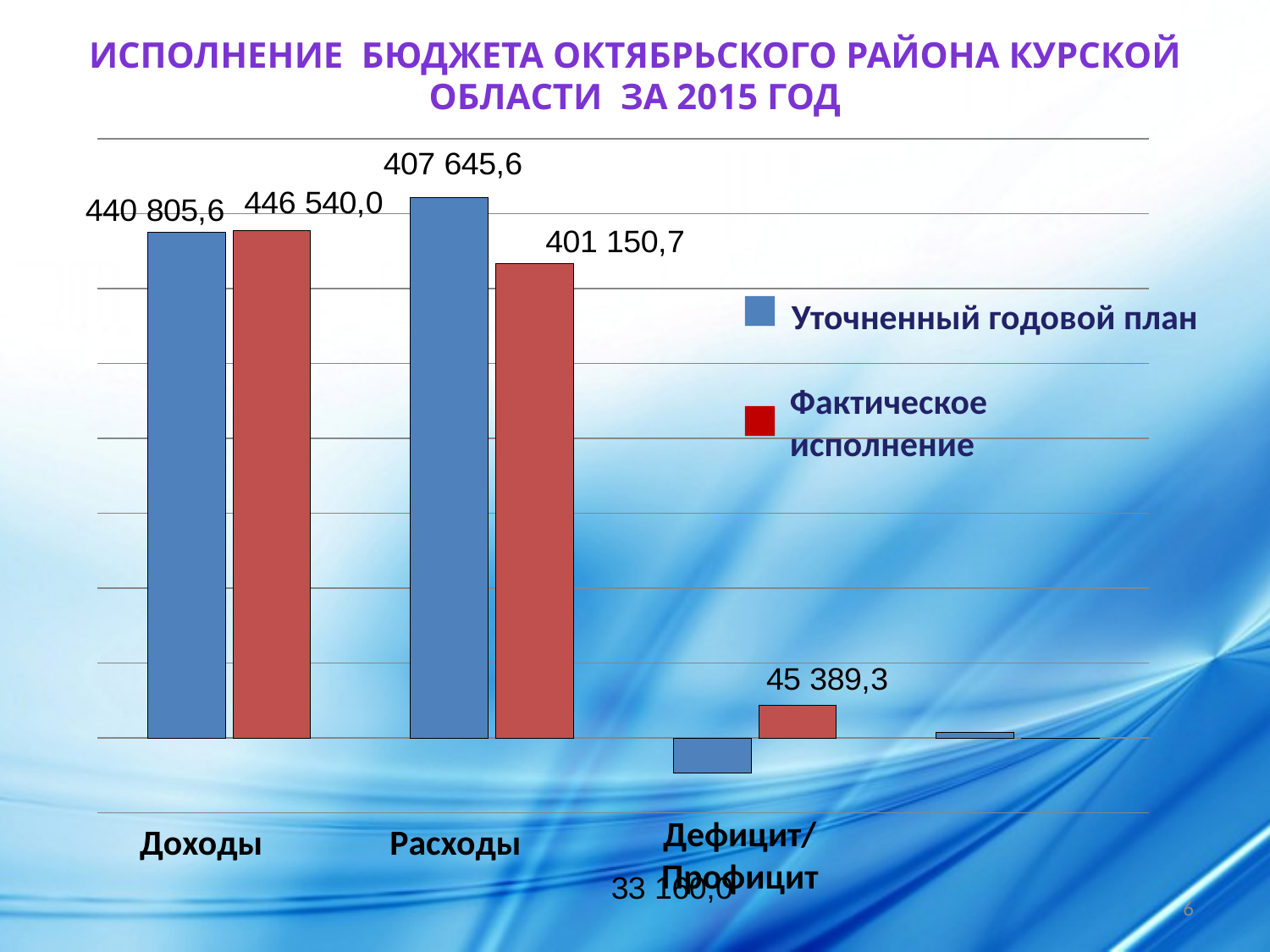
For Расходы, which is larger: Уточненный годовой план or Фактическое исполнение? Уточненный годовой план What is the value of Уточненный годовой план for Доходы? 440 805,6 By how much does Фактическое исполнение exceed Уточненный годовой план for Доходы? 5 734,4 What is the value of Уточненный годовой план for Расходы? 407 645,6 What is the difference between Уточненный годовой план and Фактическое исполнение for Расходы? 6 494,9 Which colour represents Фактическое исполнение in the legend? red What kind of chart is shown on the slide? bar chart What is the value of Фактическое исполнение for Доходы? 446 540,0 For Доходы, which is larger: Уточненный годовой план or Фактическое исполнение? Фактическое исполнение What is the value of Фактическое исполнение for Расходы? 401 150,7 What is the value of Фактическое исполнение for Дефицит/Профицит? 45 389,3 How many series does the legend list? 2